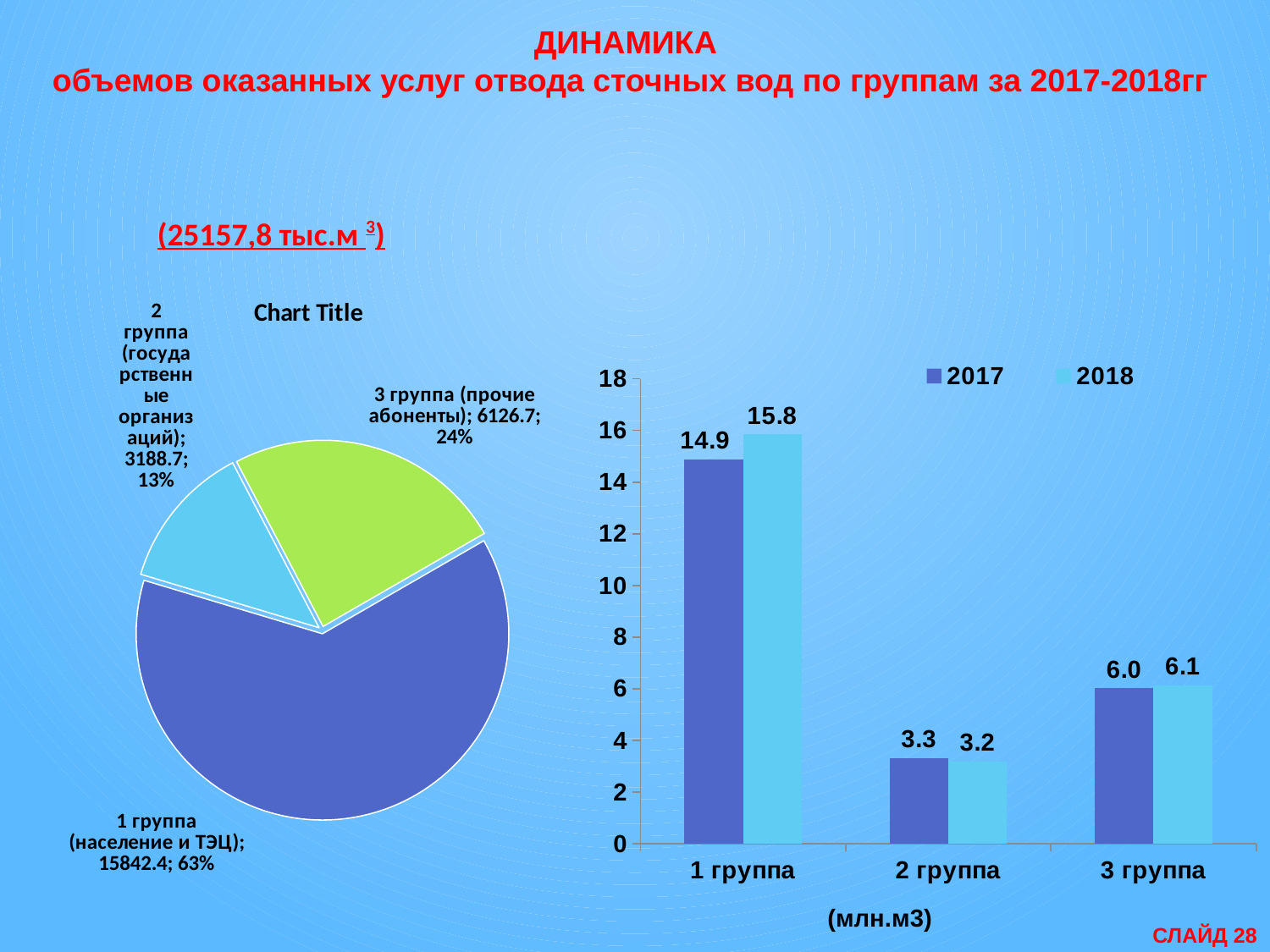
In the pie chart on the left, how many slices are there? 3 In the bar chart on the right, what is the value for 2 группа in 2017? 3.3 What kind of chart is the chart on the right side of the slide? bar chart In the pie chart on the left, what share of the pie does 2 группа (государственные организации) have? 13% In the bar chart on the right, is the 2017 value for 3 группа greater or less than 8? less In the bar chart on the right, how many series does the legend list? 2 In the pie chart on the left, which group has the largest slice? 1 группа (население и ТЭЦ) In the pie chart on the left, what share of the pie does 3 группа (прочие абоненты) have? 24% In the pie chart on the left, what value is shown for 1 группа (население и ТЭЦ)? 15842.4 In the bar chart on the right, what is the difference between the 2018 and 2017 values for 1 группа? 0.9 In the bar chart on the right, which group has the lowest value in 2018? 2 группа In the bar chart on the right, what is the value for 1 группа in 2018? 15.8